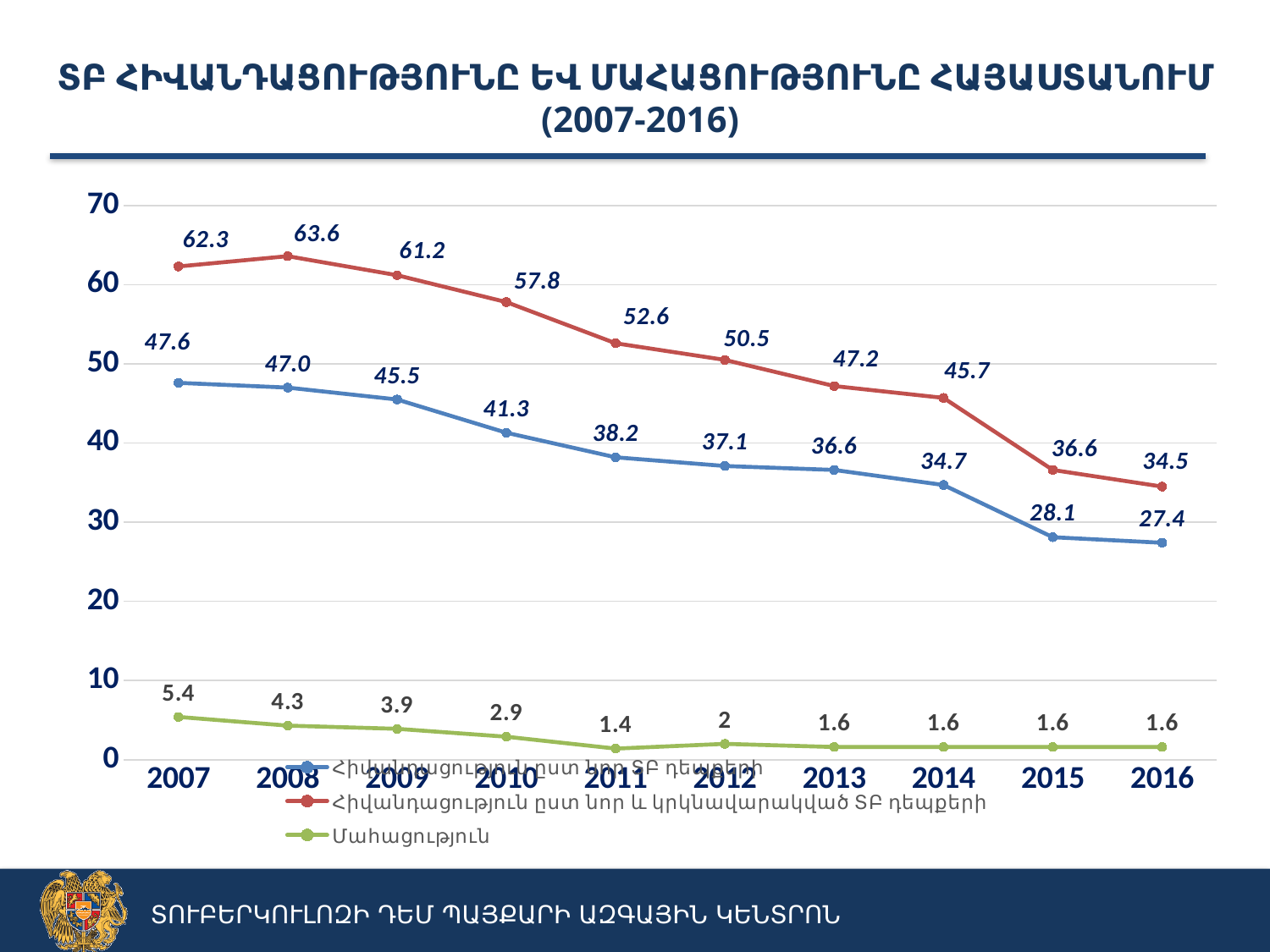
What type of chart is shown on the slide? line chart In which year does the red line reach its highest value? 2008 How many years are plotted along the x axis? 10 Which is larger in 2013: the red line value or the blue line value? the red line (47.2) What is the value of the blue line in 2015? 28.1 What is the value of the green line (Մահացություն) in 2012? 2 How many series does the legend list? 3 What is the difference between the red line and the blue line values in 2016? 7.1 What is the value of the red line (Հիվանդացություն ըստ նոր և կրկնավարակված ՏԲ դեպքերի) in 2010? 57.8 Does the blue line generally rise or fall from 2007 to 2016? fall What is the value of the green line (Մահացություն) in 2007? 5.4 In which year does the blue line reach its lowest value? 2016